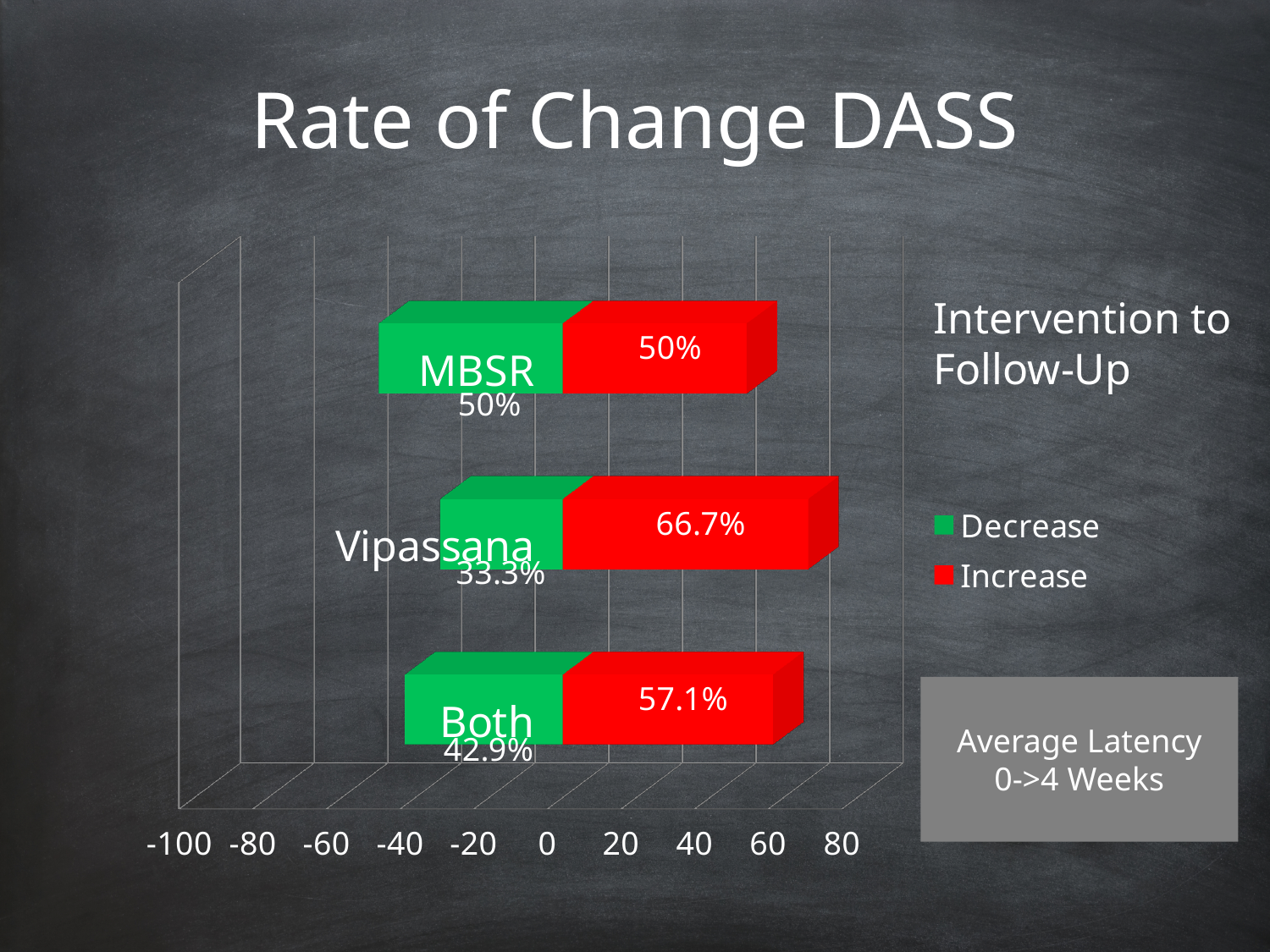
Which category has the highest Increase value? Vipassana What is the Increase value for Vipassana? 66.7% What is the Decrease value for Both? 42.9% What is the title of the chart? Rate of Change DASS What is the Increase value for MBSR? 50% Which category has the lowest Decrease value? Vipassana What is the Decrease value for Vipassana? 33.3% Which colour represents the Increase series in the legend? red How many series does the legend list? 2 What type of chart is shown on the slide? bar chart How many categories are plotted in the chart? 3 What is the difference between the Increase and Decrease values for Both? 14.2%